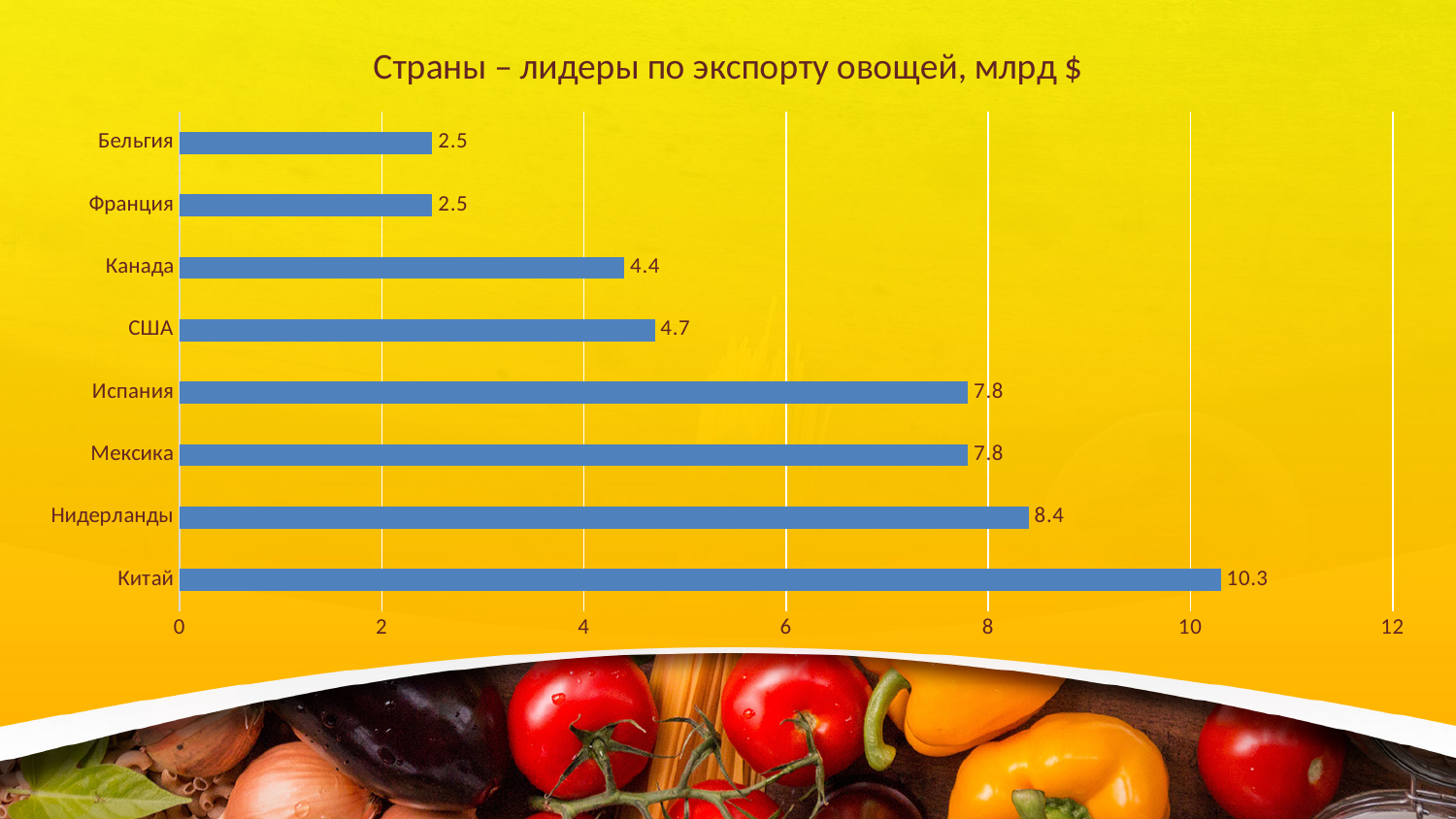
Which country has the highest value? Китай What is the difference between the values for Китай and Нидерланды? 1.9 Which is larger, the value for Испания or the value for США? Испания What is the value for Китай? 10.3 What is the value for Нидерланды? 8.4 What is the value for Франция? 2.5 What kind of chart is shown on the slide? bar chart What is the difference between the values for США and Канада? 0.3 What is the value for Канада? 4.4 Is the value for Мексика greater or less than 6? greater How many countries are shown in the chart? 8 What is the title of the chart? Страны – лидеры по экспорту овощей, млрд $